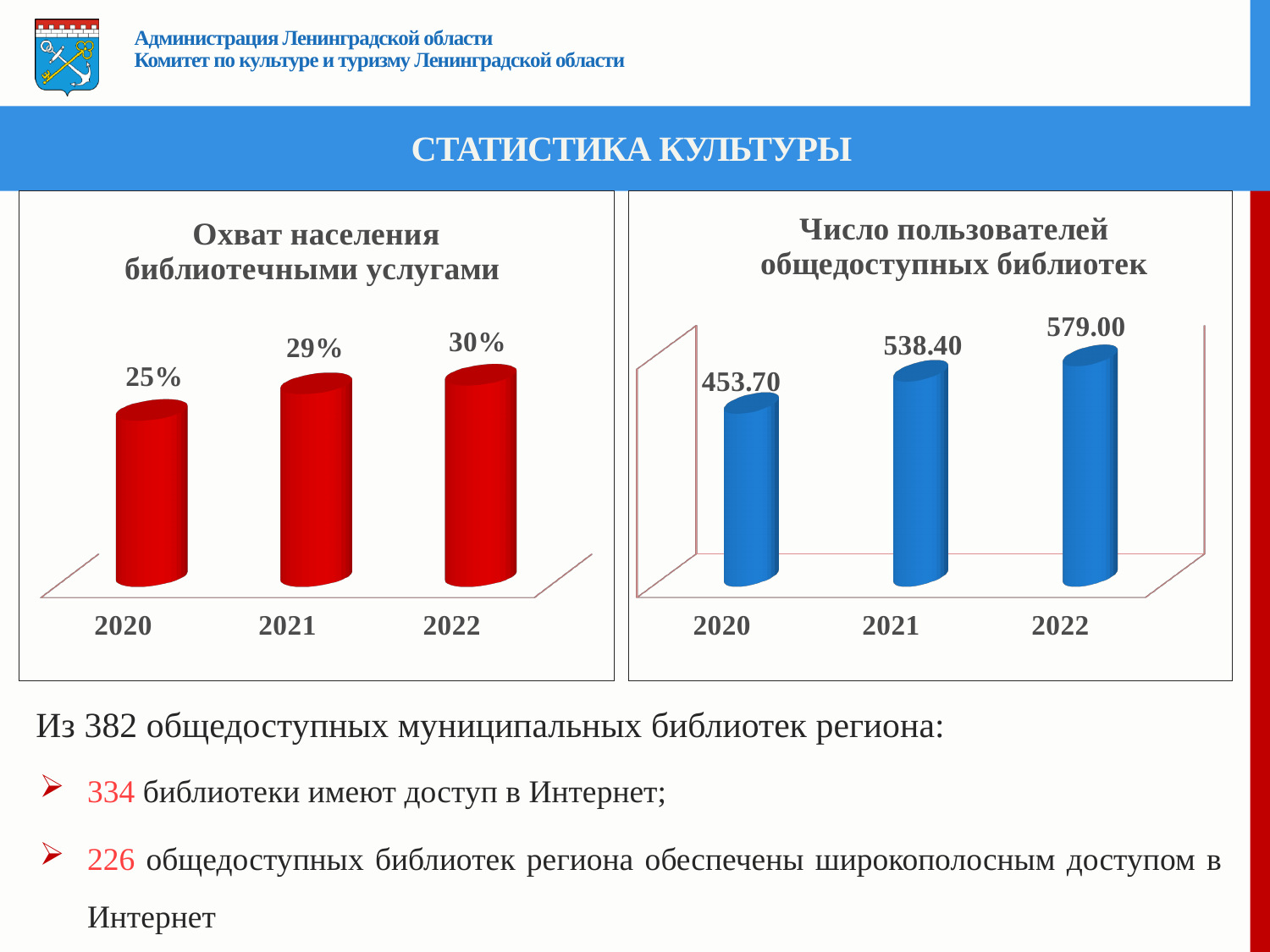
In the chart 'Число пользователей общедоступных библиотек', what is the value for 2020? 453.70 In the chart 'Число пользователей общедоступных библиотек', which is larger: the value for 2021 or the value for 2022? 2022 In the chart 'Охват населения библиотечными услугами', do the values rise or fall from 2020 to 2022? Rise How many years are shown in the chart 'Охват населения библиотечными услугами'? 3 What kind of chart is 'Число пользователей общедоступных библиотек'? Bar chart In the chart 'Число пользователей общедоступных библиотек', what is the value for 2022? 579.00 In the chart 'Число пользователей общедоступных библиотек', what is the difference between the values for 2021 and 2020? 84.70 In the chart 'Охват населения библиотечными услугами', what is the difference between the values for 2022 and 2020? 5% In the chart 'Число пользователей общедоступных библиотек', which year has the lowest value? 2020 In the chart 'Охват населения библиотечными услугами', what is the value for 2021? 29% In the chart 'Охват населения библиотечными услугами', which year has the highest value? 2022 What colour are the bars in the chart 'Число пользователей общедоступных библиотек'? Blue